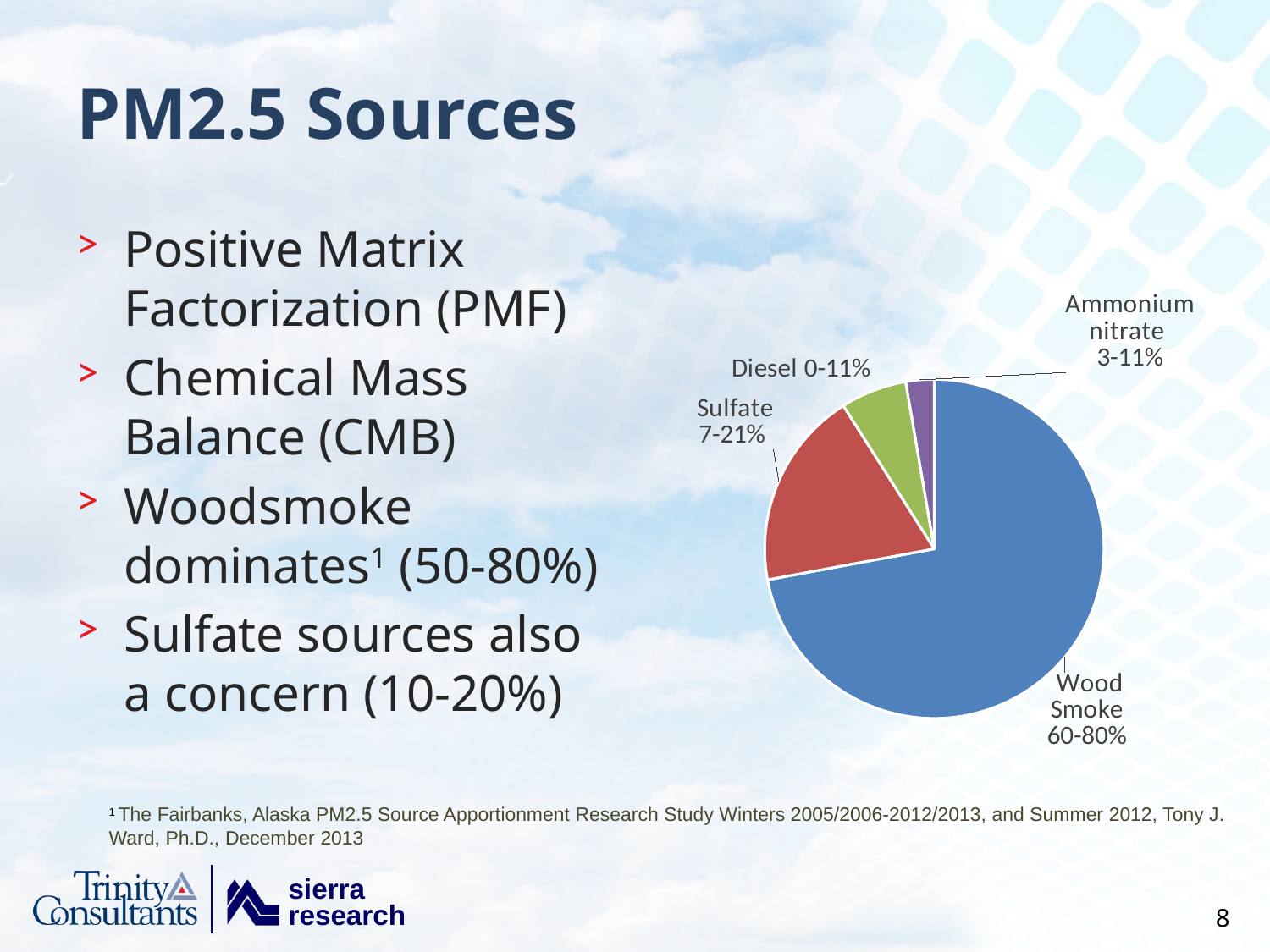
What colour is the Wood Smoke slice in the pie chart? blue Which source has the smallest slice in the pie chart? Ammonium nitrate What range is labelled for Sulfate in the pie chart? 7-21% What kind of chart is shown on the slide? pie chart What range is labelled for Diesel in the pie chart? 0-11% How many slices does the pie chart have? 4 What colour is the Sulfate slice in the pie chart? red Which source has the largest slice in the pie chart? Wood Smoke What range is labelled for Ammonium nitrate in the pie chart? 3-11% Which slice is larger in the pie chart, Wood Smoke or Sulfate? Wood Smoke What range is labelled for Wood Smoke in the pie chart? 60-80% Which slice is larger in the pie chart, Sulfate or Diesel? Sulfate